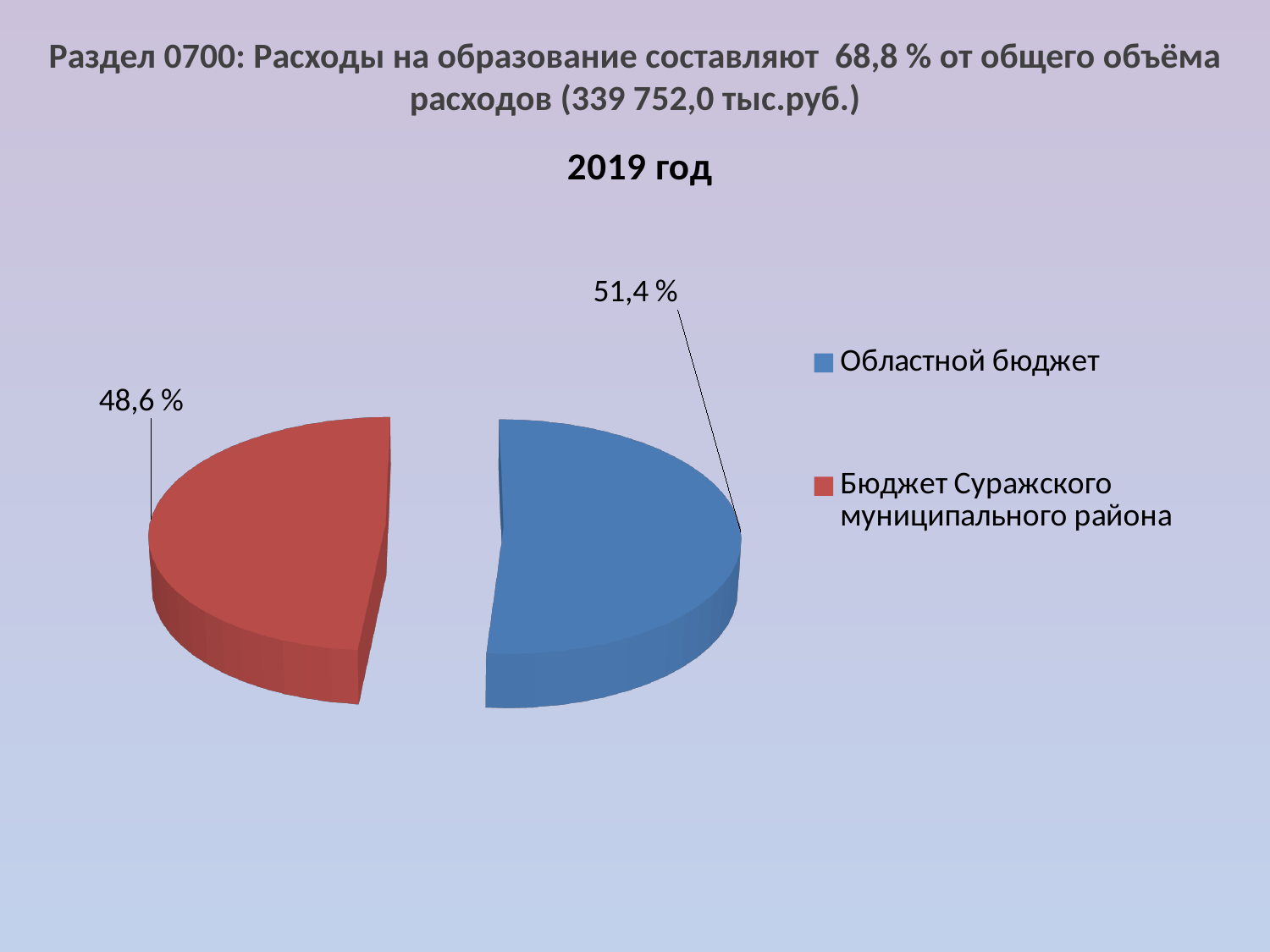
What share of the pie does Областной бюджет represent? 51,4 % How many entries does the legend list? 2 Which slice of the pie is the smallest? Бюджет Суражского муниципального района What colour is the slice for Бюджет Суражского муниципального района? Red Which slice of the pie is the largest? Областной бюджет What share of the pie does Бюджет Суражского муниципального района represent? 48,6 % How many slices does the pie chart have? 2 What year does the chart title refer to? 2019 год What kind of chart is shown on the slide? Pie chart What is the difference in percentage points between the Областной бюджет slice and the Бюджет Суражского муниципального района slice? 2,8 Which is larger: the share for Областной бюджет or the share for Бюджет Суражского муниципального района? Областной бюджет